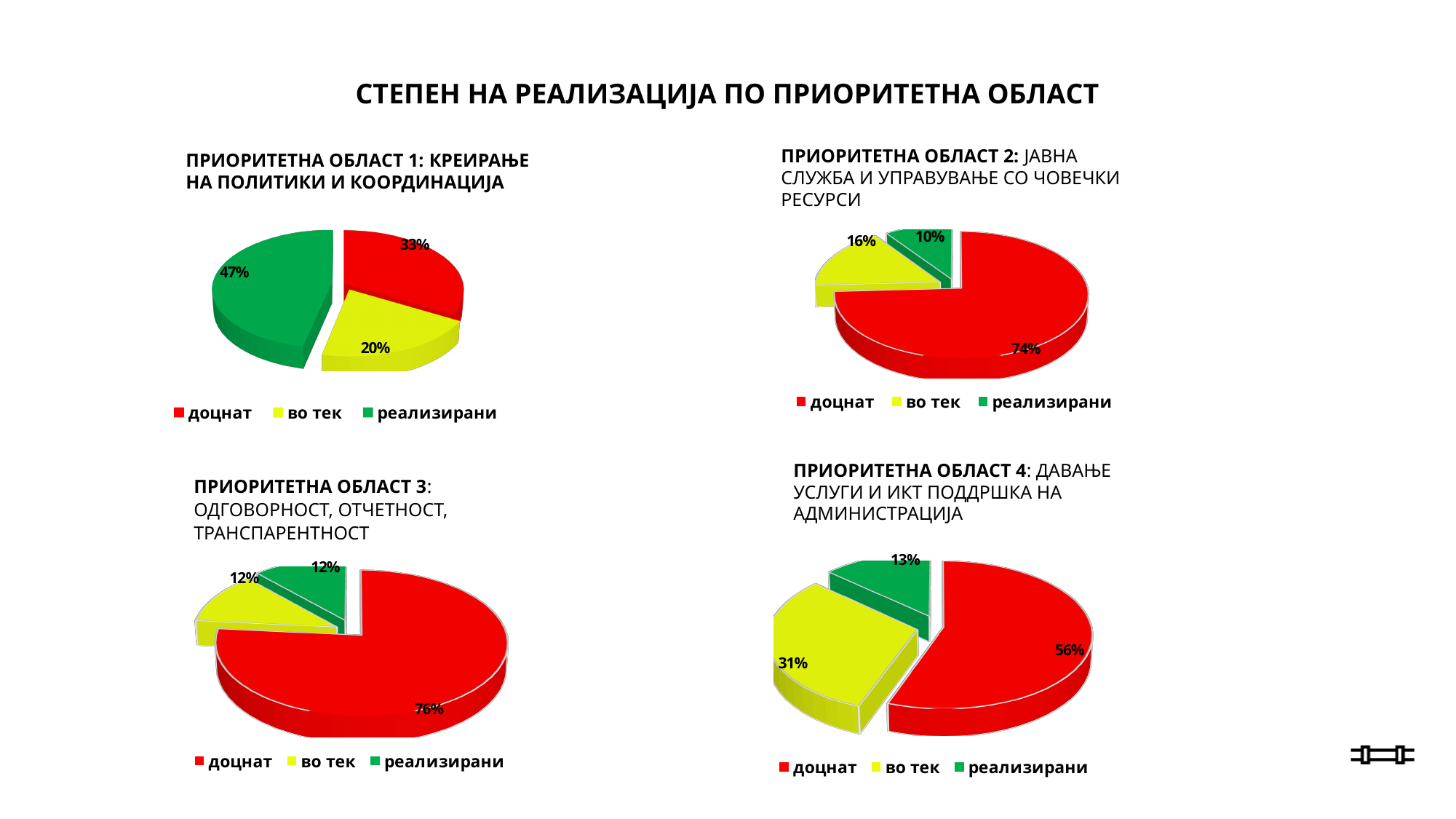
What type of chart is used for Приоритетна област 3 (bottom left)? Pie chart In the pie chart for Приоритетна област 3 (bottom left), what share is labelled for доцнат? 76% In the pie chart for Приоритетна област 3 (bottom left), what is the difference between the доцнат share and the во тек share? 64% In the pie chart for Приоритетна област 2 (top right), which category has the smallest slice? реализирани In the pie chart for Приоритетна област 1 (top left), what share is labelled for во тек? 20% In the pie chart for Приоритетна област 4 (bottom right), which category has the largest slice? доцнат How many entries does the legend of the pie chart for Приоритетна област 4 (bottom right) list? 3 In the pie chart for Приоритетна област 1 (top left), which is larger, the доцнат slice or the реализирани slice? реализирани In the pie chart for Приоритетна област 1 (top left), what share is labelled for реализирани? 47% How many slices does the pie chart for Приоритетна област 2 (top right) have? 3 In the pie chart for Приоритетна област 4 (bottom right), what share is labelled for во тек? 31% In the pie chart for Приоритетна област 2 (top right), what share is labelled for доцнат? 74%